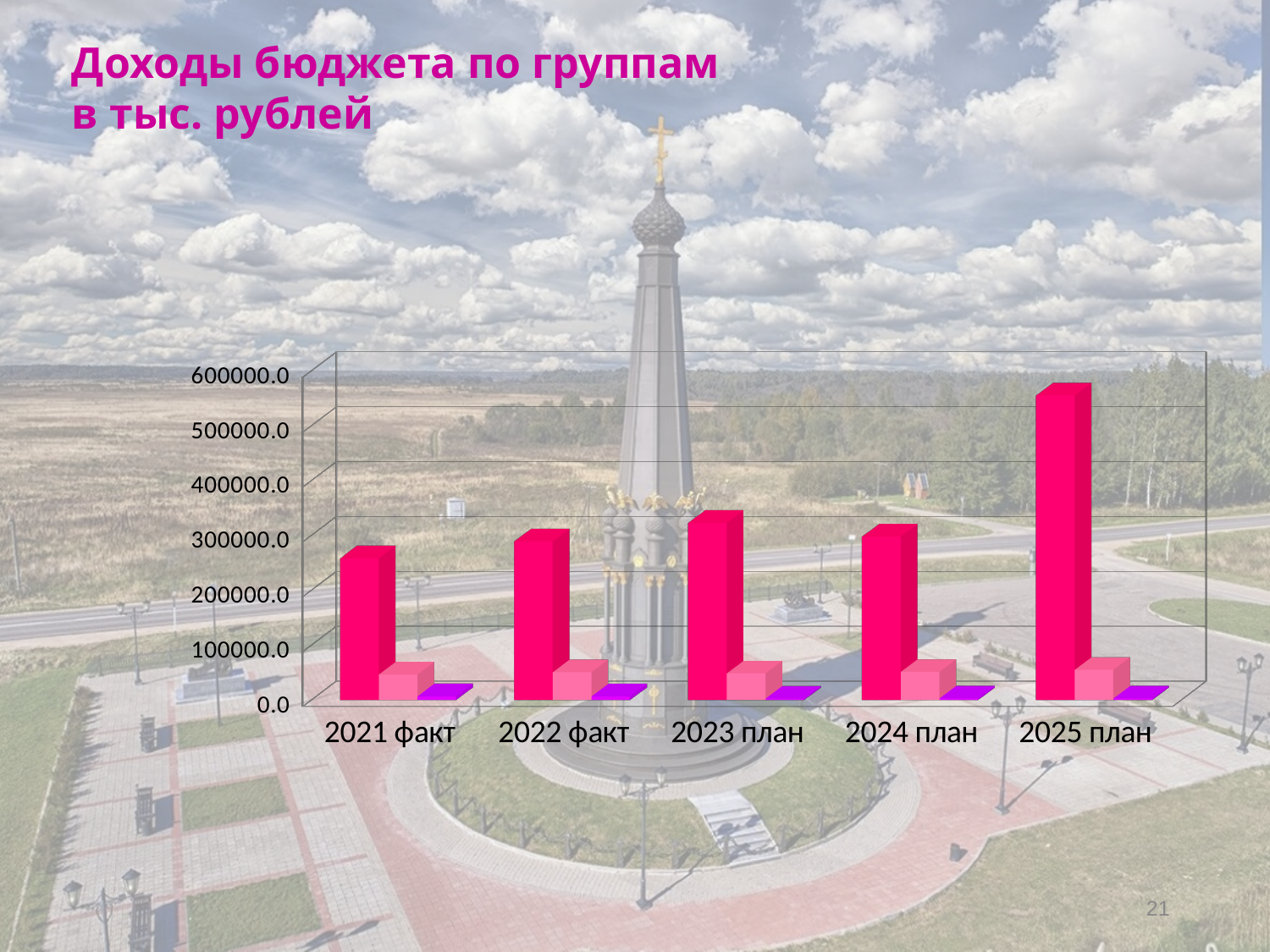
Among the tallest (magenta) bars, which category has the lowest value? 2021 факт How many bars are plotted for each category on the chart? 3 What kind of chart is shown on the slide? bar chart Is the value of the tallest bar for 2023 план greater or less than 300000.0? greater Is the tallest bar for 2025 план larger or smaller than the tallest bar for 2024 план? larger How many categories are shown along the x axis of the chart? 5 Is the value of the tallest bar for 2021 факт greater or less than 300000.0? less What is the highest value shown on the vertical axis of the chart? 600000.0 Which category has the tallest bar on the chart? 2025 план What is the title of the chart on the slide? Доходы бюджета по группам в тыс. рублей Is the value of the tallest bar for 2021 факт greater or less than 200000.0? greater